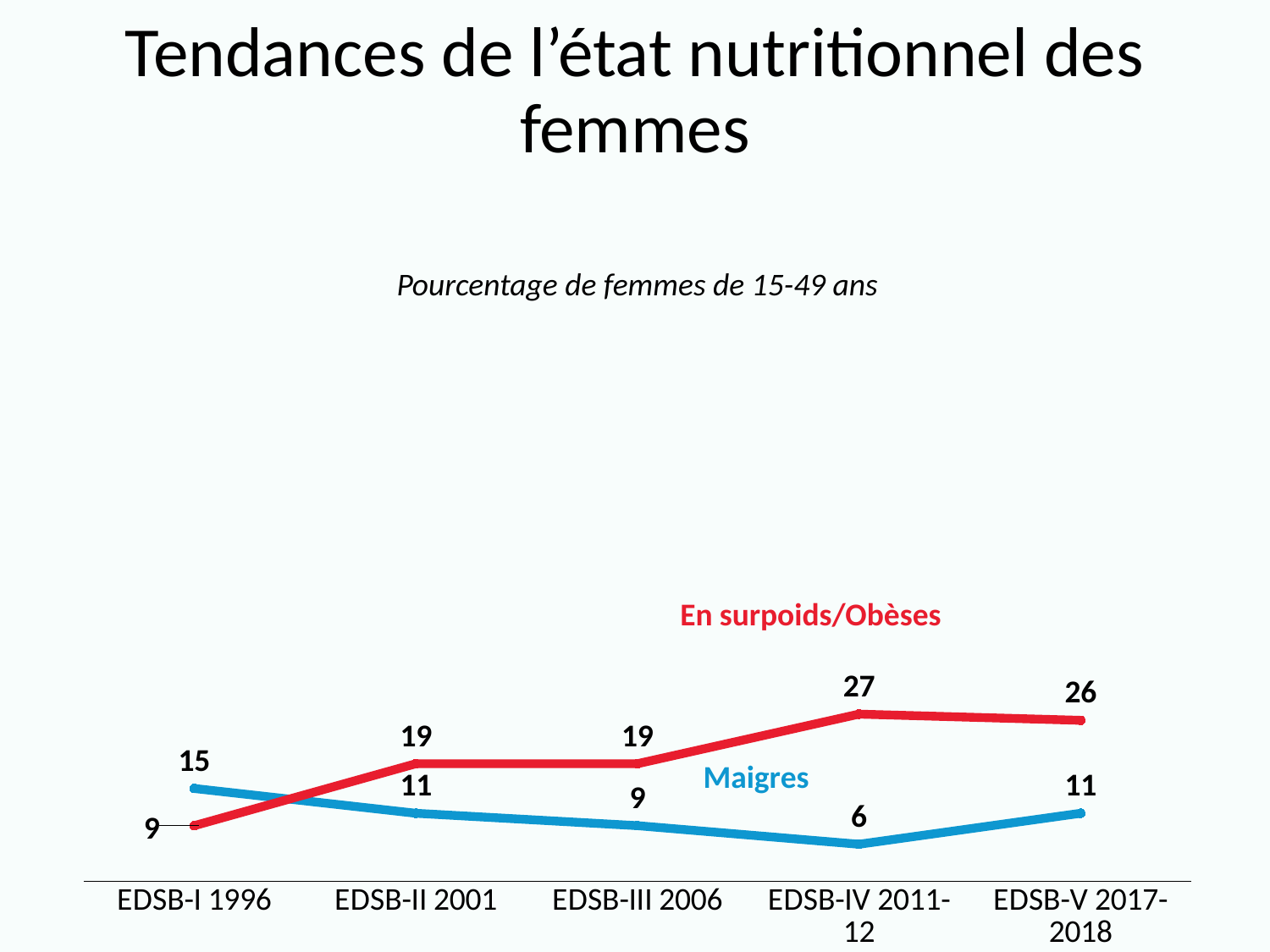
What is the difference between En surpoids/Obèses and Maigres at EDSB-V 2017-2018? 15 How many series are plotted on the chart? 2 What is the value for En surpoids/Obèses at EDSB-IV 2011-12? 27 Which is larger at EDSB-I 1996: Maigres or En surpoids/Obèses? Maigres What is the value for Maigres at EDSB-I 1996? 15 How many survey points are plotted on the x axis? 5 Does the En surpoids/Obèses line generally rise or fall from EDSB-I 1996 to EDSB-IV 2011-12? rise At which survey is the En surpoids/Obèses value highest? EDSB-IV 2011-12 What is the value for Maigres at EDSB-V 2017-2018? 11 What is the value for En surpoids/Obèses at EDSB-I 1996? 9 What type of chart is shown on the slide? line chart At which survey is the Maigres value lowest? EDSB-IV 2011-12